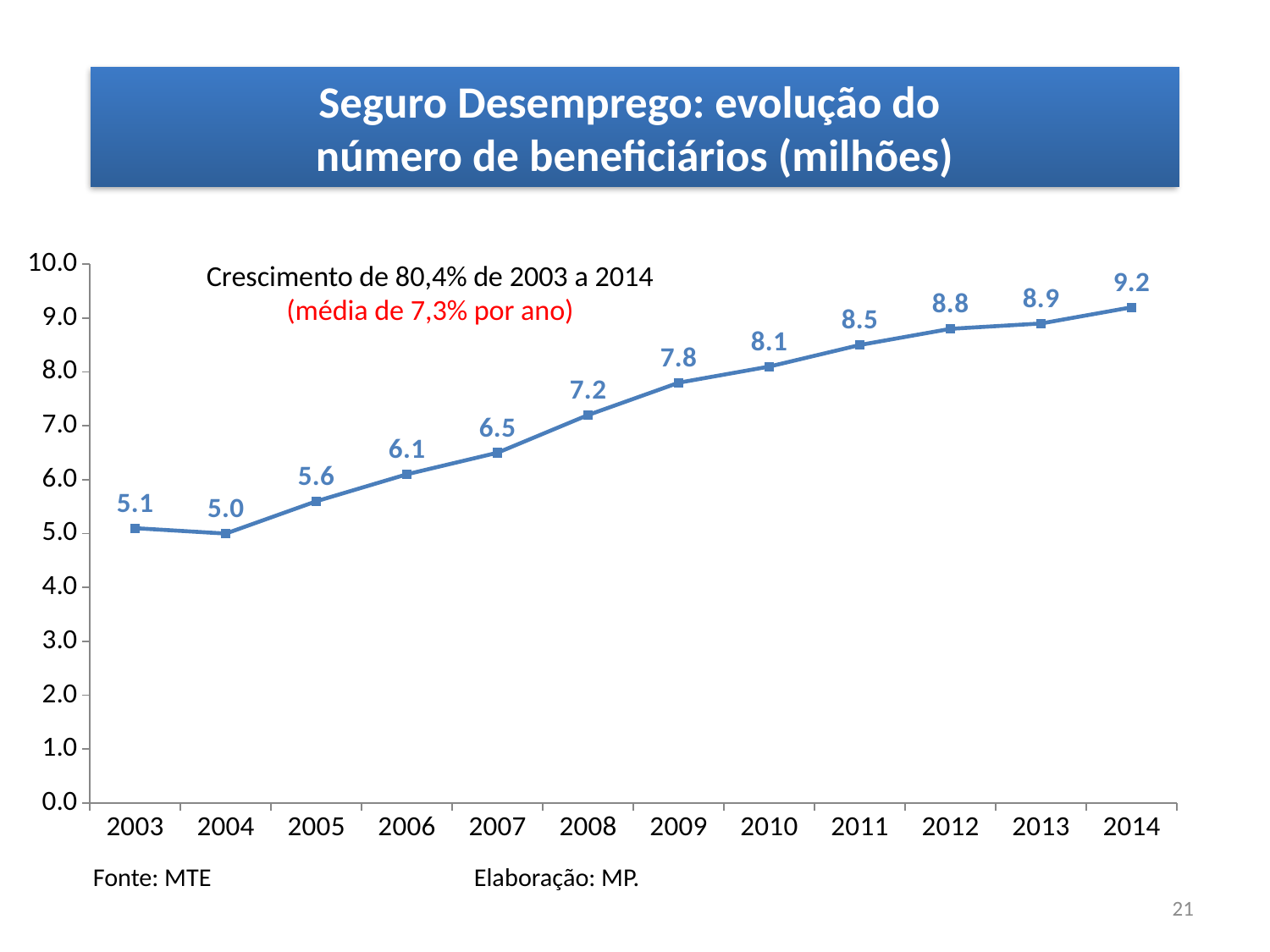
What is the difference between the values for 2014 and 2003? 4.1 What kind of chart is shown? line chart Do the values generally rise or fall from 2004 to 2014? rise Which is larger, the value for 2005 or the value for 2006? 2006 What is the difference between the values for 2008 and 2007? 0.7 Is the value for 2010 greater or less than 8.0? greater What is the value for 2014? 9.2 What is the value for 2003? 5.1 Which year has the lowest value? 2004 How many years are plotted on the chart? 12 What is the value for 2009? 7.8 Which year has the highest value? 2014